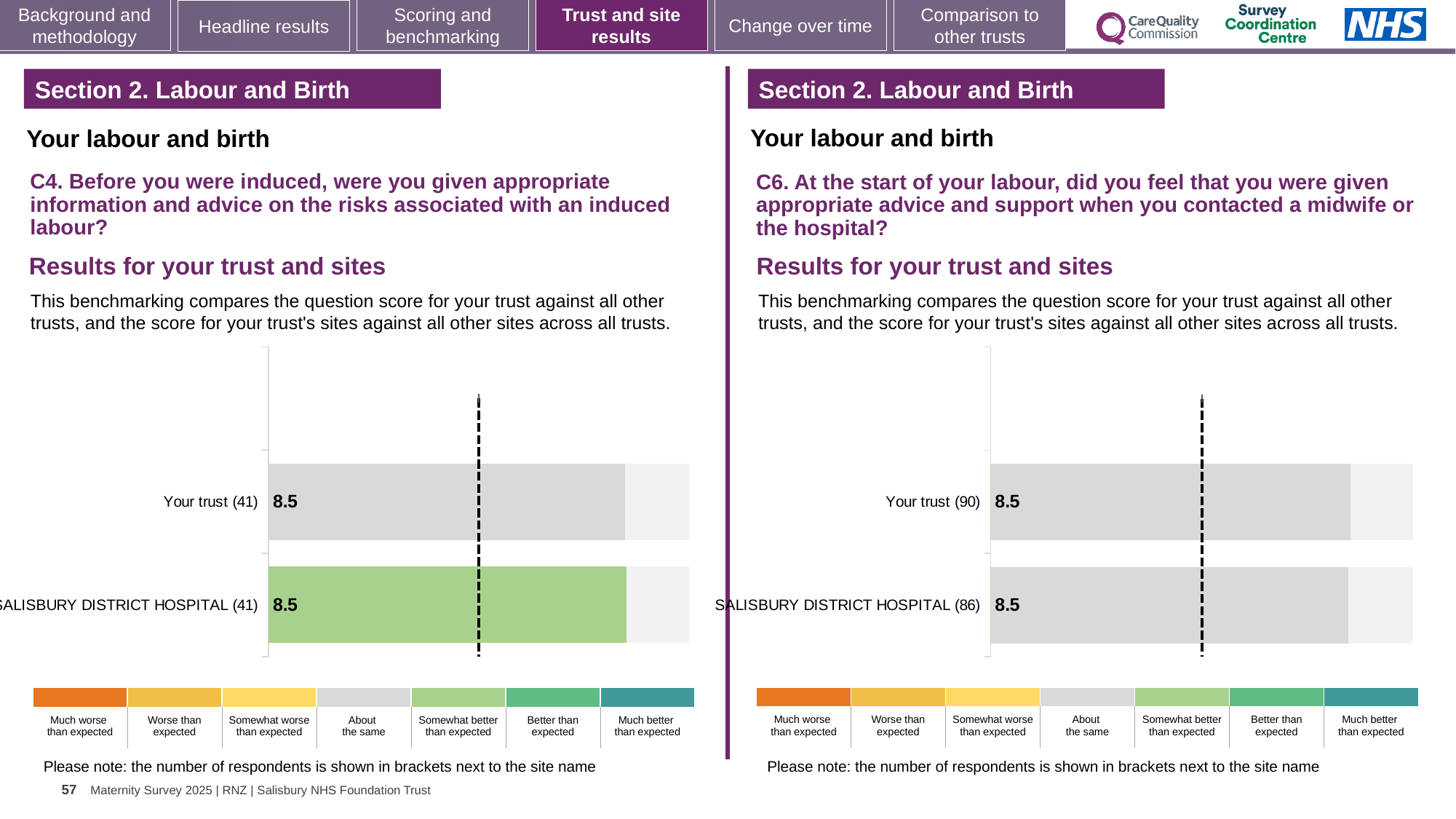
In the right chart (C6), what is the score for Your trust? 8.5 In the right chart (C6), is the score for Your trust greater or less than the score for SALISBURY DISTRICT HOSPITAL, or are they equal? equal In the left chart (C4), how many respondents are shown in brackets for Your trust? 41 In the left chart (C4), what is the difference between the score for Your trust and the score for SALISBURY DISTRICT HOSPITAL? 0 In the left chart (C4), what is the score for SALISBURY DISTRICT HOSPITAL? 8.5 In the left chart (C4), what is the score for Your trust? 8.5 In the right chart (C6), how many respondents are shown in brackets for SALISBURY DISTRICT HOSPITAL? 86 How many bars are plotted in the right chart (C6)? 2 What type of chart is used in the left chart (C4)? bar chart In the right chart (C6), what is the score for SALISBURY DISTRICT HOSPITAL? 8.5